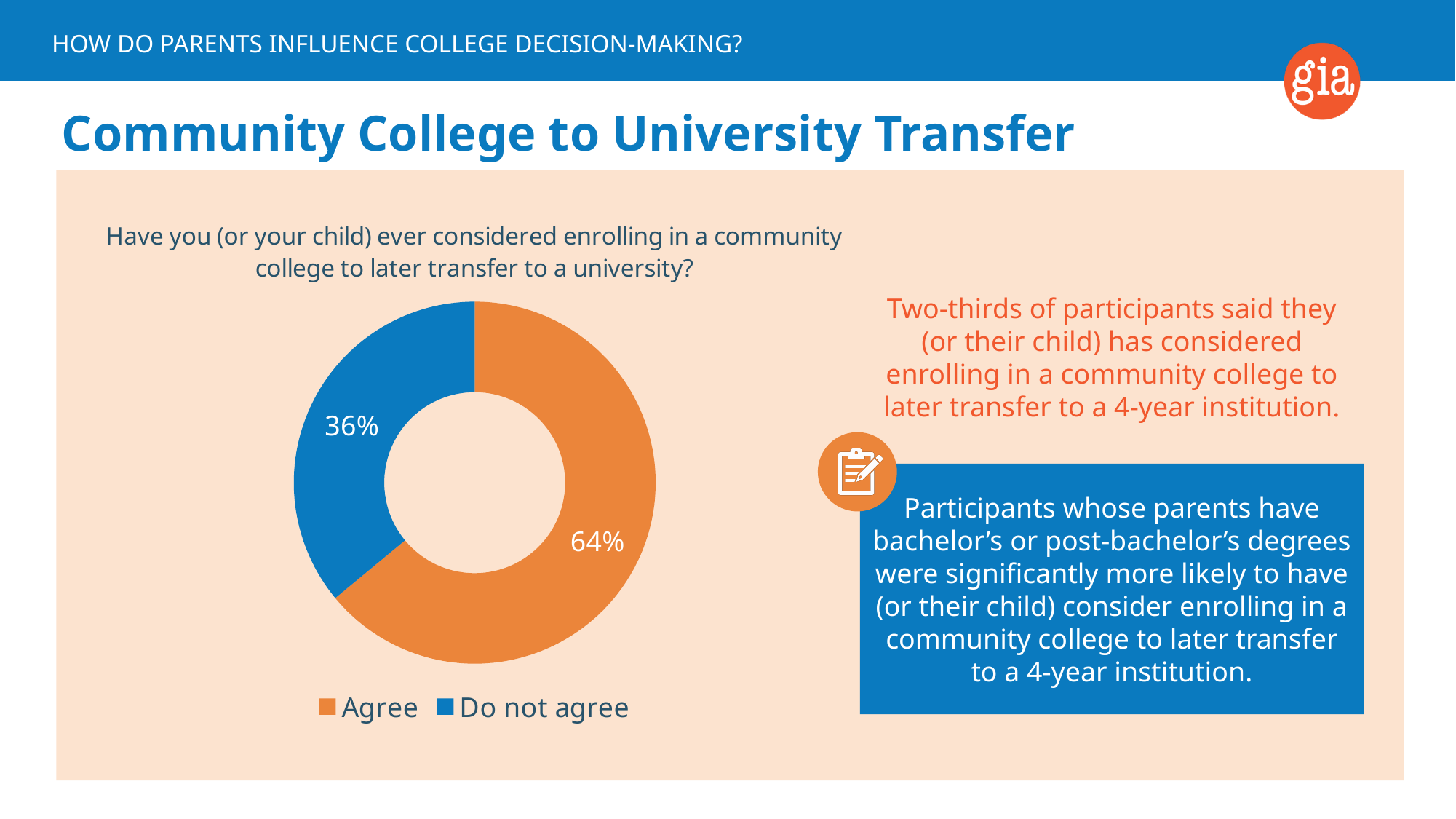
What is the difference in percentage points between "Agree" and "Do not agree"? 28 How many categories does the chart show? 2 How many entries does the legend list? 2 What colour represents "Do not agree" in the chart? Blue Which response has the smaller share of the chart? Do not agree Is the share for "Agree" larger or smaller than the share for "Do not agree"? larger What percentage of participants answered "Do not agree"? 36% What percentage of participants answered "Agree"? 64% What question does the chart title ask? Have you (or your child) ever considered enrolling in a community college to later transfer to a university? Which response has the larger share of the chart? Agree What kind of chart is shown on the slide? Doughnut (pie) chart What share of the chart does the "Agree" slice represent? 64%